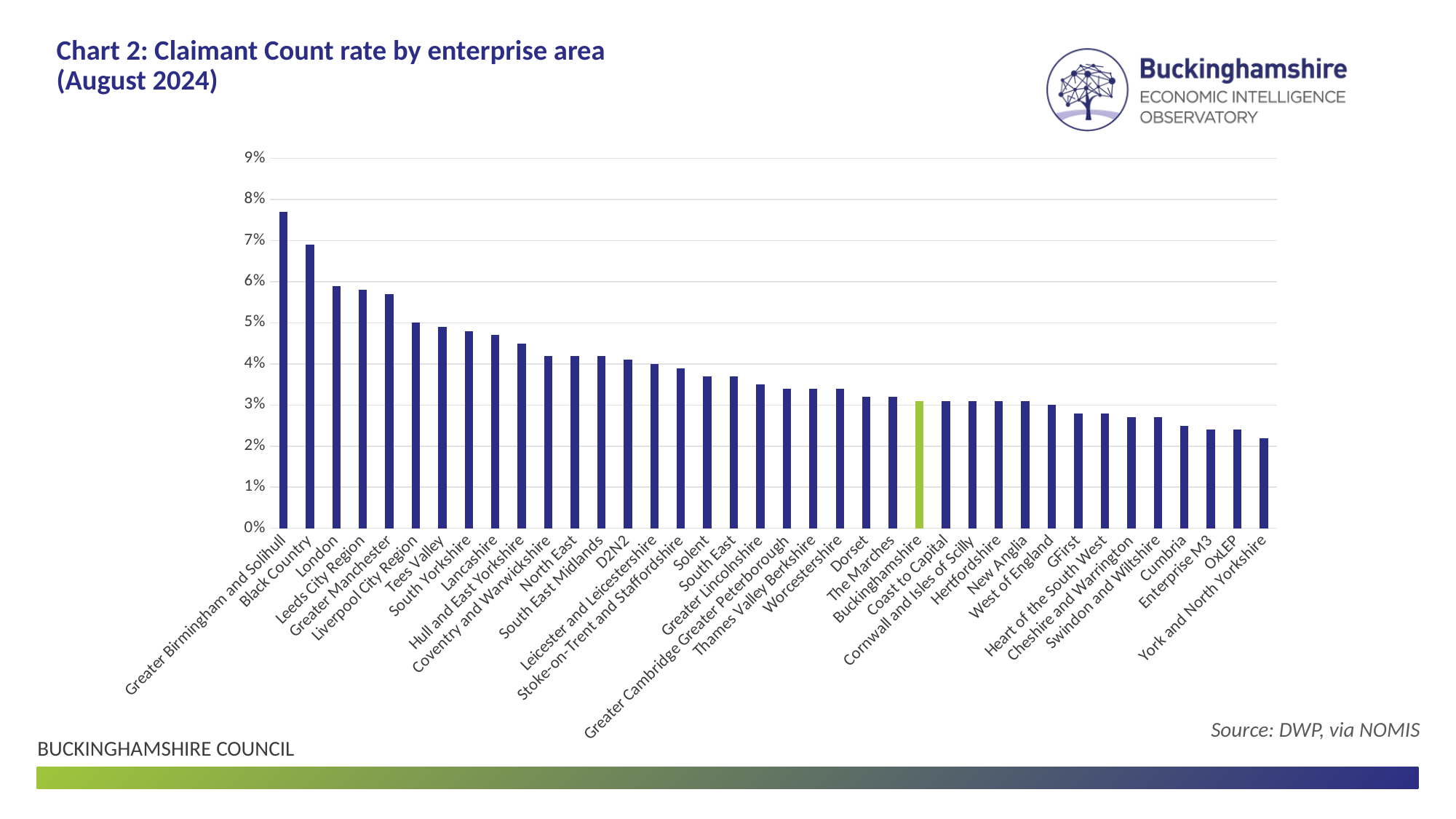
Do the Claimant Count rates rise or fall moving from left to right along the x axis? Fall Is the Claimant Count rate for Solent greater or less than 4%? less Is the Claimant Count rate for Greater Birmingham and Solihull greater or less than 7%? greater Which enterprise area has the lowest Claimant Count rate? York and North Yorkshire What kind of chart is shown on the slide? Bar chart Which has the higher Claimant Count rate, Greater Birmingham and Solihull or Black Country? Greater Birmingham and Solihull Which enterprise area has the highest Claimant Count rate? Greater Birmingham and Solihull Is the Claimant Count rate for Hull and East Yorkshire greater or less than 5%? less Which enterprise area's bar is highlighted in green rather than blue? Buckinghamshire How many enterprise areas are plotted on the chart? 38